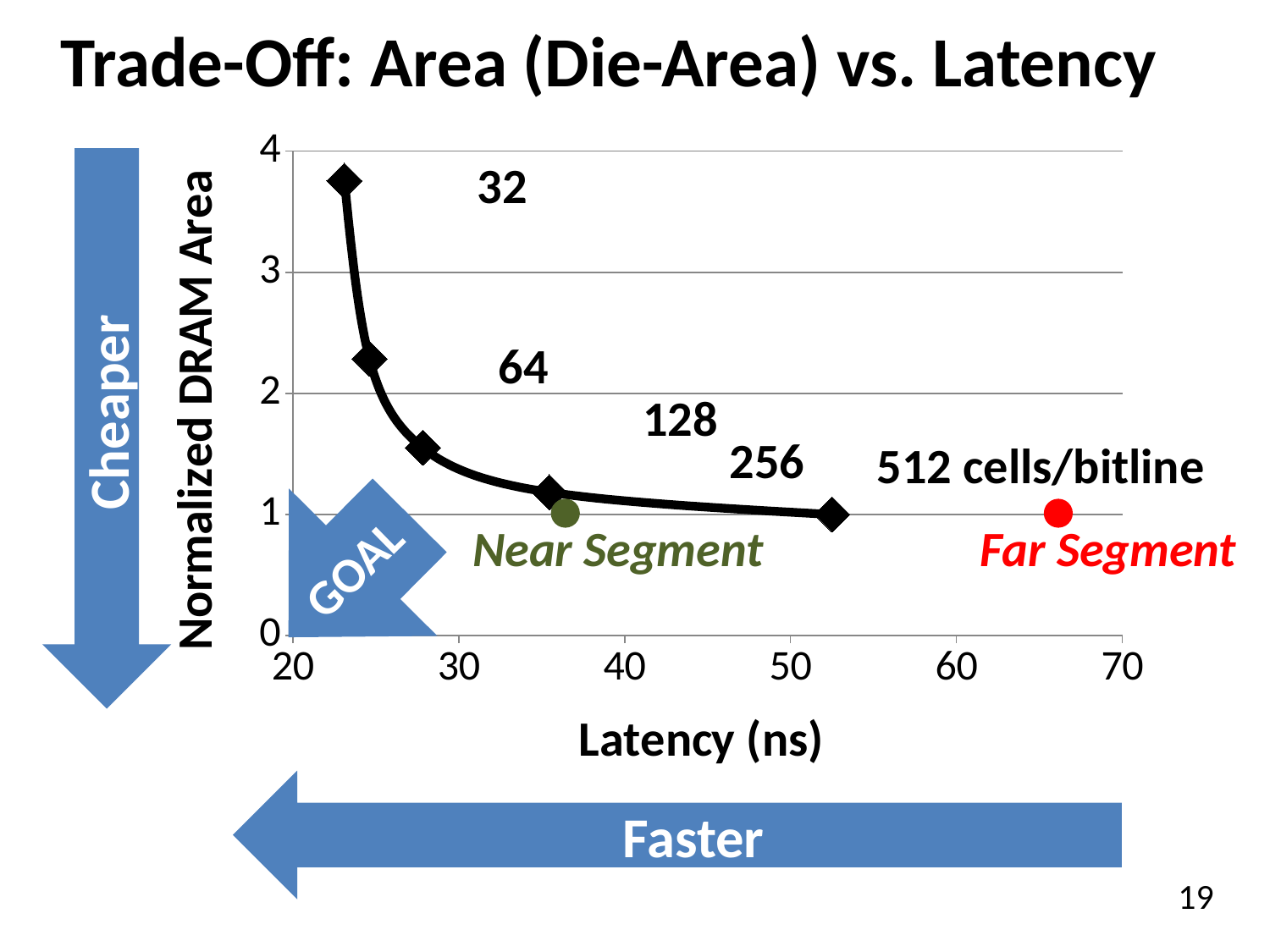
As latency increases along the x axis, does the Normalized DRAM Area rise or fall? fall How many cells/bitline data points are plotted on the black curve? 5 Which has the larger Normalized DRAM Area, 64 cells/bitline or 128 cells/bitline? 64 cells/bitline Is the Normalized DRAM Area for 32 cells/bitline greater or less than 3? greater Which cells/bitline configuration has the lowest Normalized DRAM Area? 512 Is the latency of the Far Segment greater or less than 60 ns? greater Is the Normalized DRAM Area for 128 cells/bitline greater or less than 2? less What kind of chart is shown on the slide? line chart Which cells/bitline configuration has the highest Normalized DRAM Area? 32